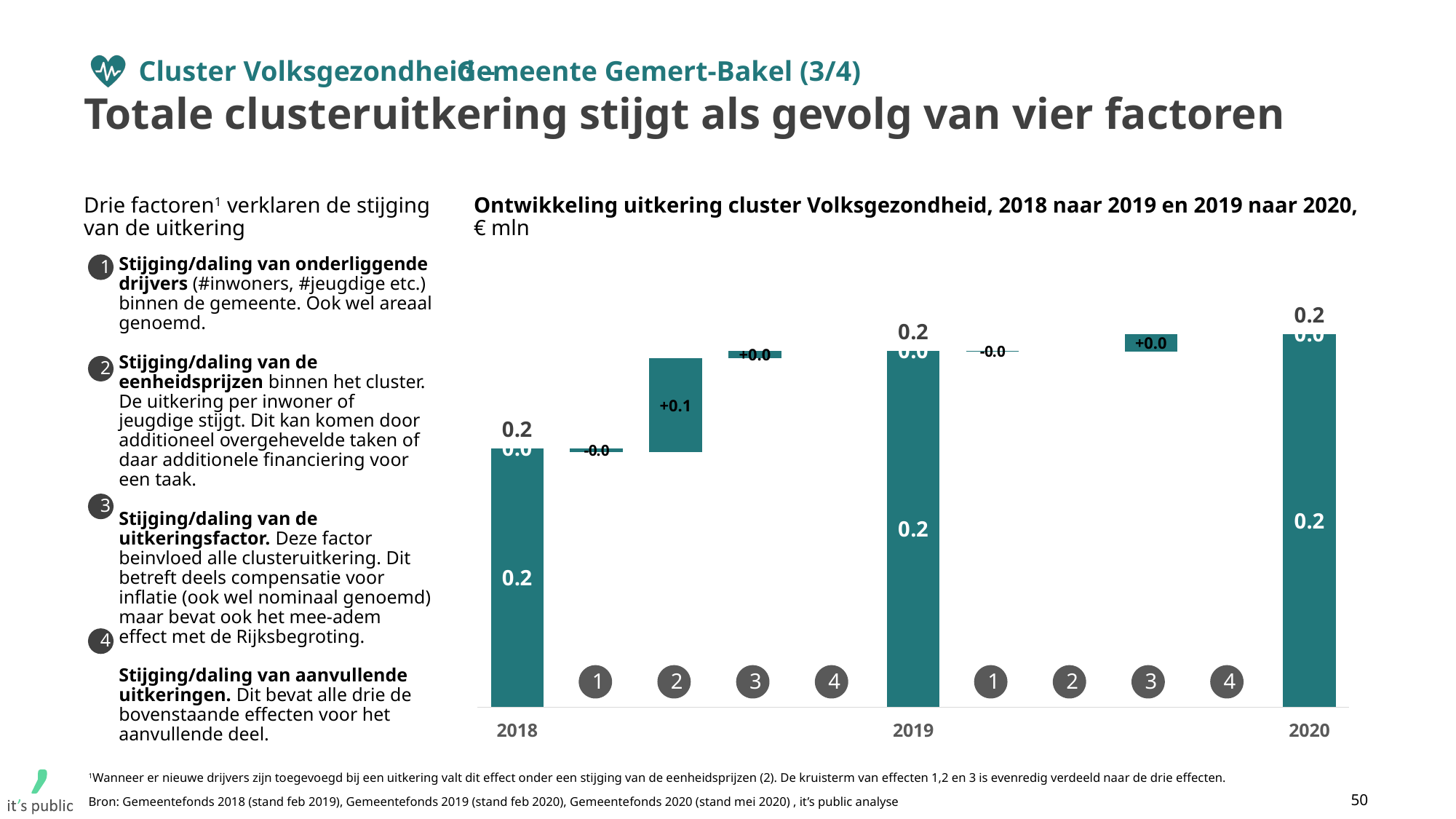
What is the total uitkering for 2018 shown on the chart? 0.2 What is the effect of factor 2 between 2018 and 2019? +0.1 What is the effect of factor 3 between 2018 and 2019? +0.0 Which factor has the largest effect between 2018 and 2019? Factor 2 What kind of chart is shown on the slide? bar chart How many numbered factors are shown between each pair of years? 4 What is the total uitkering for 2020 shown on the chart? 0.2 In what unit are the values on the chart expressed? € mln What is the effect of factor 1 between 2018 and 2019? -0.0 How many years are shown with a total bar on the chart? 3 What is the total uitkering for 2019 shown on the chart? 0.2